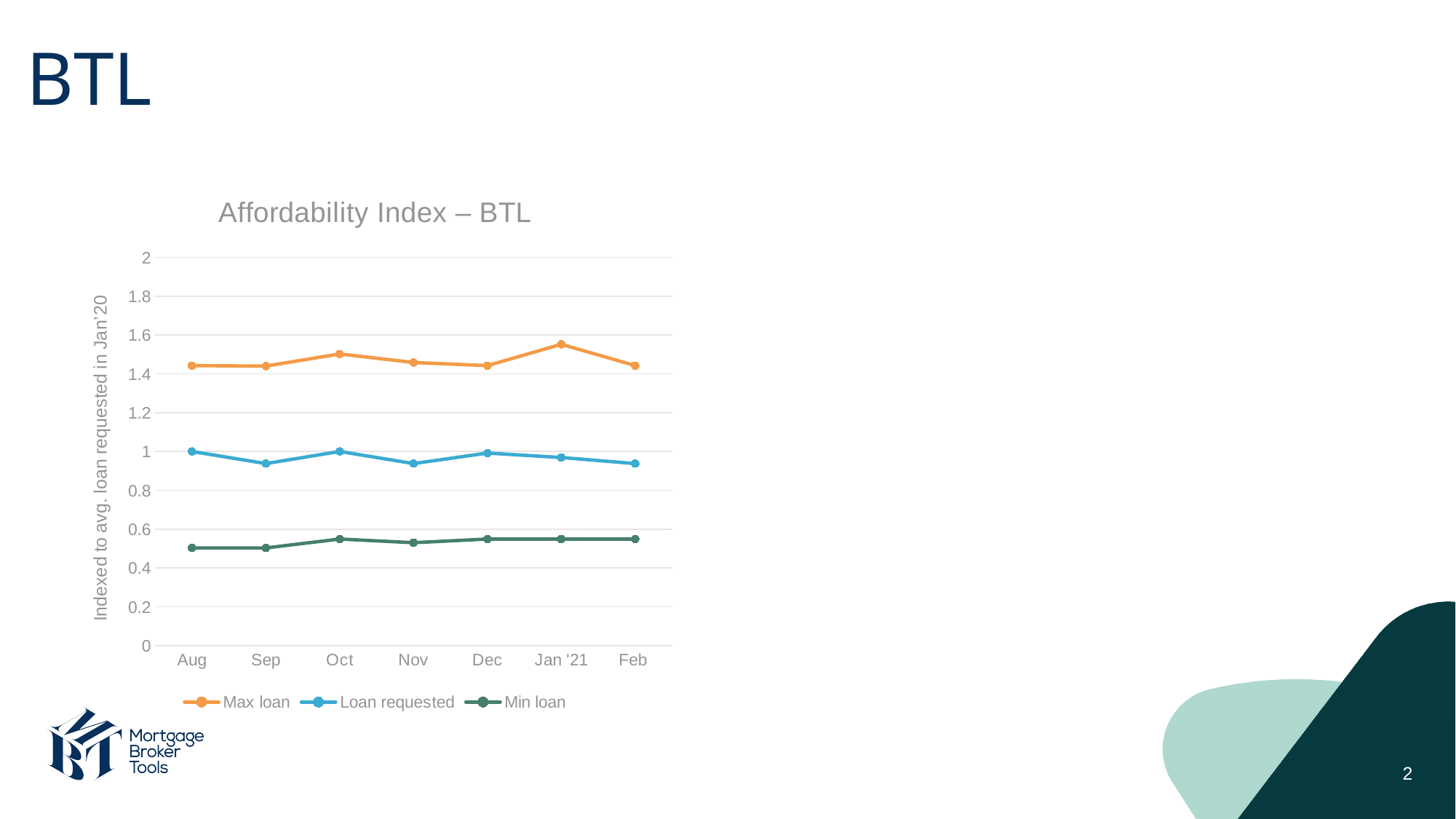
Is the Max loan value in Oct greater or less than 1.6? less What kind of chart is shown on the slide? line chart Is the Loan requested value in Sep greater or less than 1? less How many months are plotted along the x axis? 7 How many series does the legend list? 3 In Dec, which series has the larger value: Max loan or Loan requested? Max loan Is the Max loan value in Jan '21 greater or less than 1.4? greater In which month does the Max loan series reach its highest value? Jan '21 What is the title of the chart? Affordability Index – BTL Which series has the lowest values across all months? Min loan What is the label on the vertical axis? Indexed to avg. loan requested in Jan'20